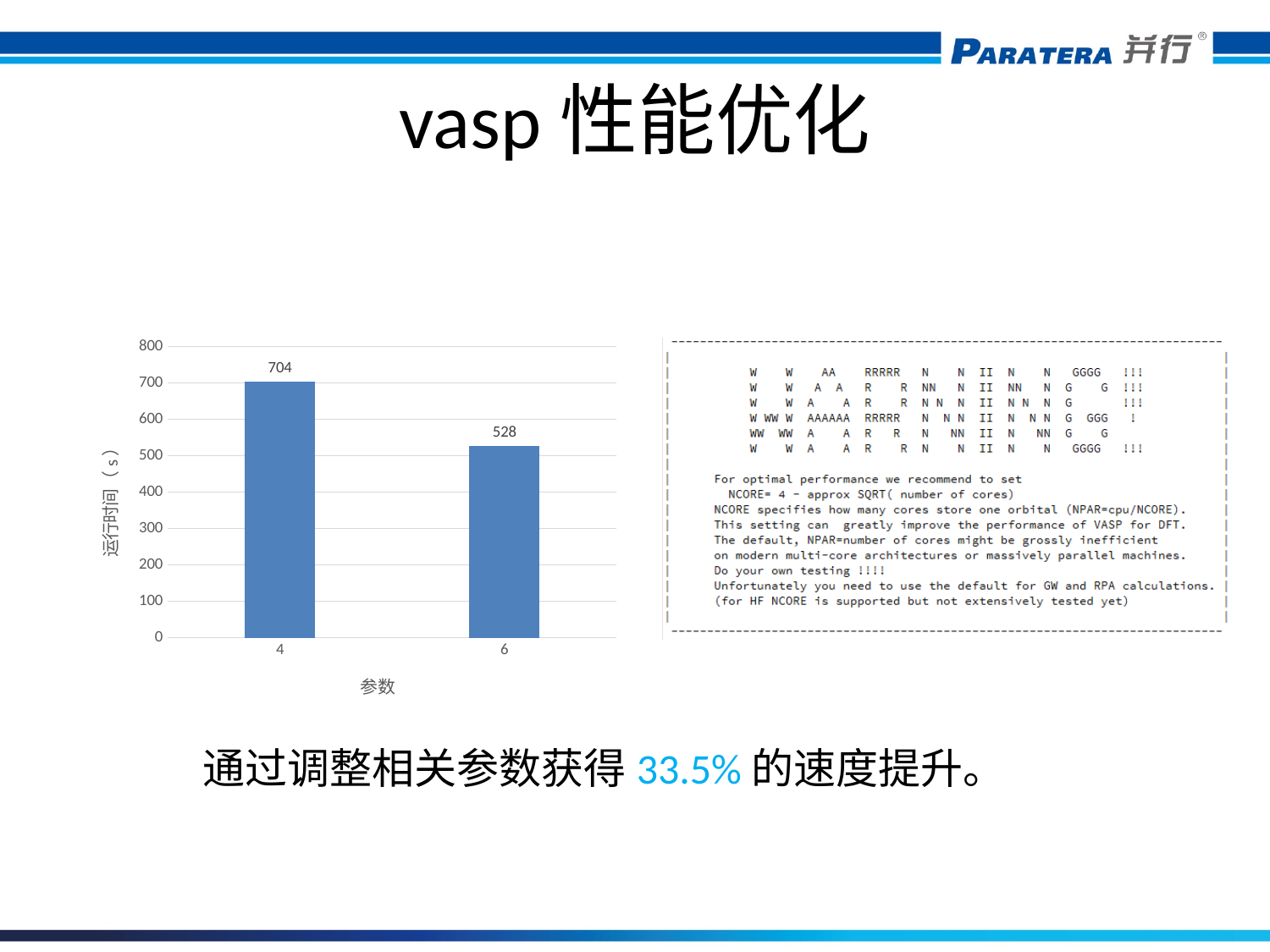
Which has a larger running time, parameter 4 or parameter 6? 4 How many parameter values (categories) are shown in the chart? 2 Is the running time for parameter 6 greater or less than 600? less What kind of chart is shown on the slide? bar chart What is the running time (运行时间) for parameter value 6? 528 Which parameter value has the highest running time? 4 What is the difference in running time between parameter 4 and parameter 6? 176 What is the label of the x axis of the chart? 参数 Is the running time for parameter 4 greater or less than 700? greater Does the running time rise or fall as the parameter value increases from 4 to 6? fall Which parameter value has the lowest running time? 6 What is the running time (运行时间) for parameter value 4? 704